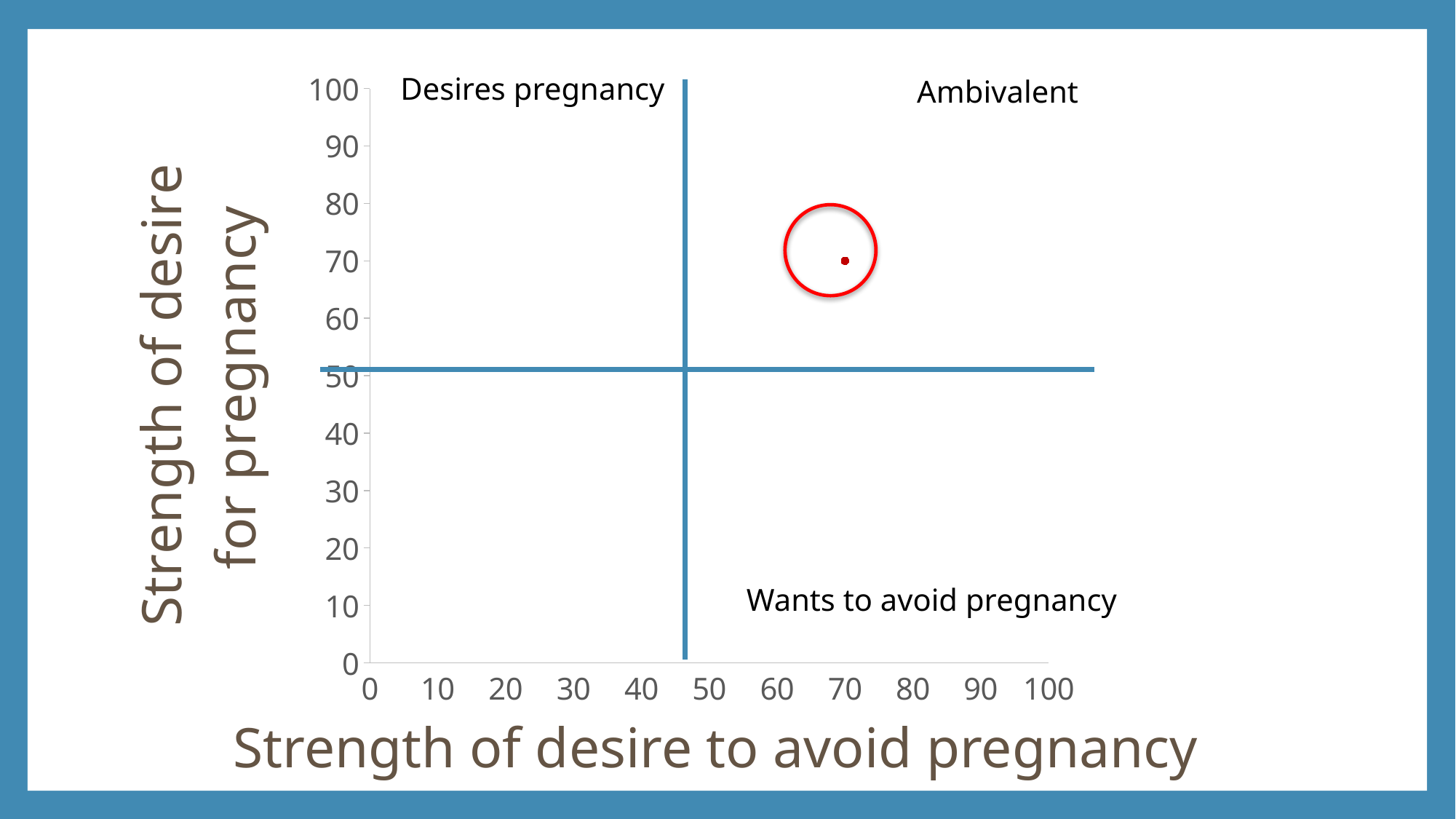
What is the title of the x axis? Strength of desire to avoid pregnancy What kind of chart is shown on the slide? scatter chart What is the y-axis value (strength of desire for pregnancy) of the plotted point? 70 What is the x-axis value (strength of desire to avoid pregnancy) of the plotted point? 70 Which quadrant label is the circled point located in? Ambivalent Is the plotted point's strength of desire to avoid pregnancy greater or less than 50? greater Is the plotted point's strength of desire for pregnancy greater or less than 80? less What is the maximum value shown on the y axis? 100 How many data points are plotted on the chart? 1 Is the plotted point's strength of desire for pregnancy greater or less than 50? greater